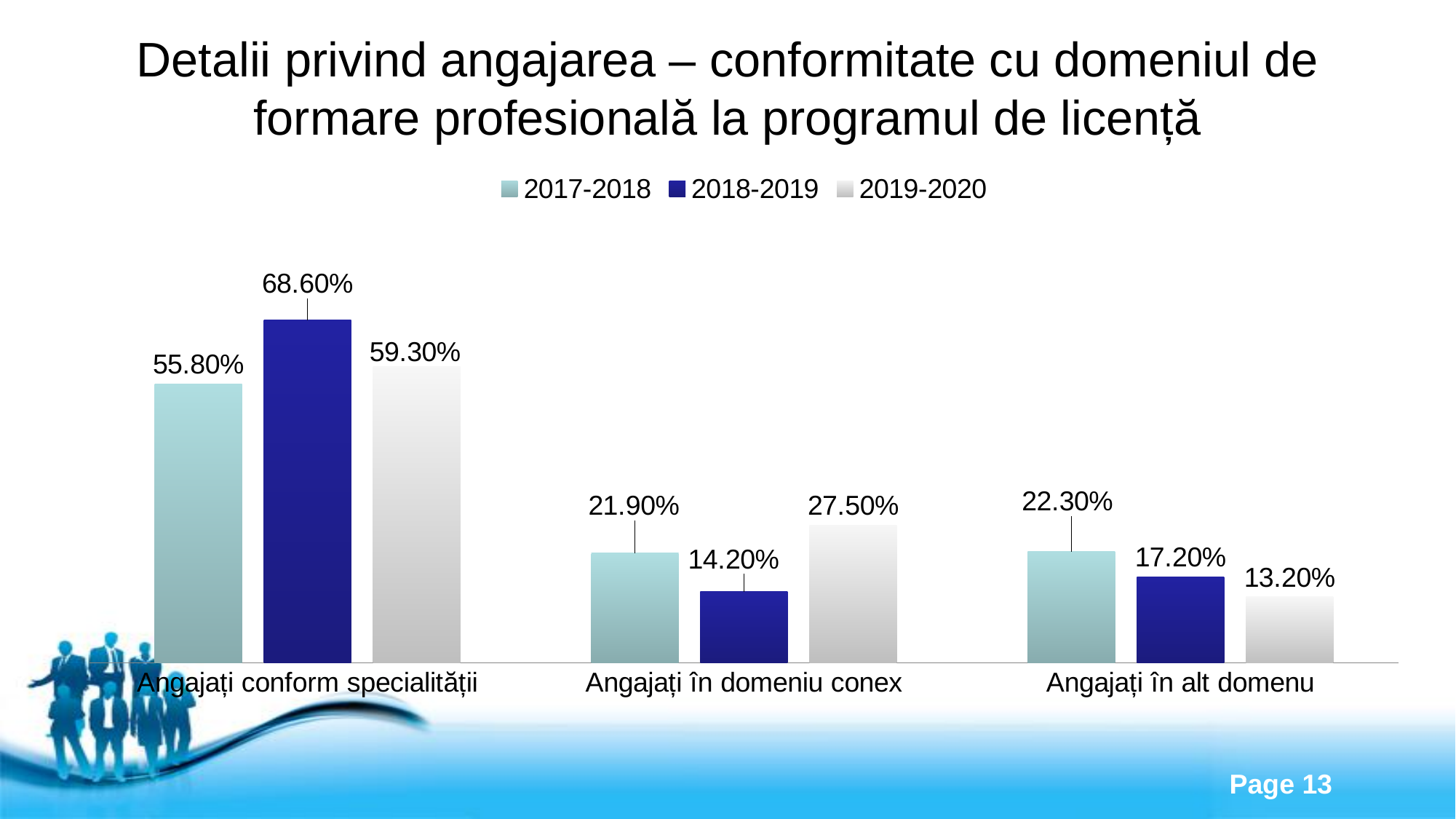
Which series has the highest value in the 'Angajați conform specialității' category? 2018-2019 What kind of chart is shown on the slide? Bar chart How many categories are shown on the x axis? 3 What is the difference between the 2019-2020 and 2018-2019 values in the 'Angajați în domeniu conex' category? 13.30% What is the value for 2017-2018 in the 'Angajați în alt domenu' category? 22.30% How many series does the legend list? 3 What is the value for 2018-2019 in the 'Angajați conform specialității' category? 68.60% Which is larger: the 2017-2018 value for 'Angajați în domeniu conex' or the 2017-2018 value for 'Angajați în alt domenu'? Angajați în alt domenu What is the value for 2019-2020 in the 'Angajați în domeniu conex' category? 27.50% Which series is shown in dark blue in the legend? 2018-2019 What is the difference between the 2018-2019 and 2017-2018 values in the 'Angajați conform specialității' category? 12.80% Which series has the lowest value in the 'Angajați în alt domenu' category? 2019-2020